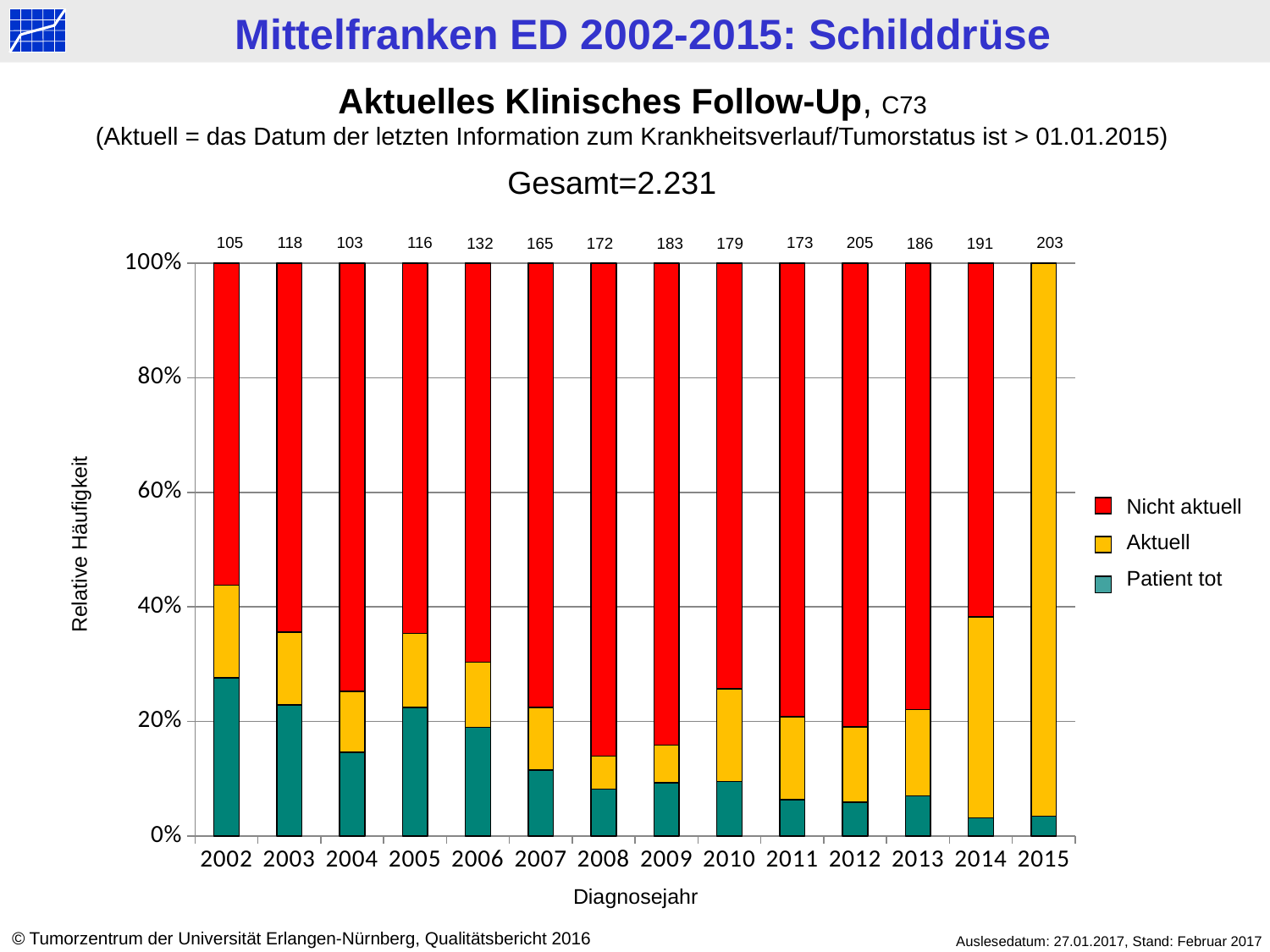
Which diagnosis year has the lowest number printed above its bar? 2004 How many series does the legend list? 3 Is the 'Patient tot' share for 2002 greater or less than 20%? greater What is the number printed above the bar for 2013? 186 What is the number printed above the bar for 2006? 132 What is the difference between the numbers printed above the bars for 2012 and 2004? 102 How many diagnosis years are shown on the x axis? 14 What kind of chart is shown on the slide? Stacked bar chart Which diagnosis year has the highest number printed above its bar? 2012 Does the 'Patient tot' share generally rise or fall from 2002 to 2015? fall Is the 'Nicht aktuell' share for 2008 greater or less than 80%? greater Which year has the larger number printed above its bar, 2009 or 2010? 2009